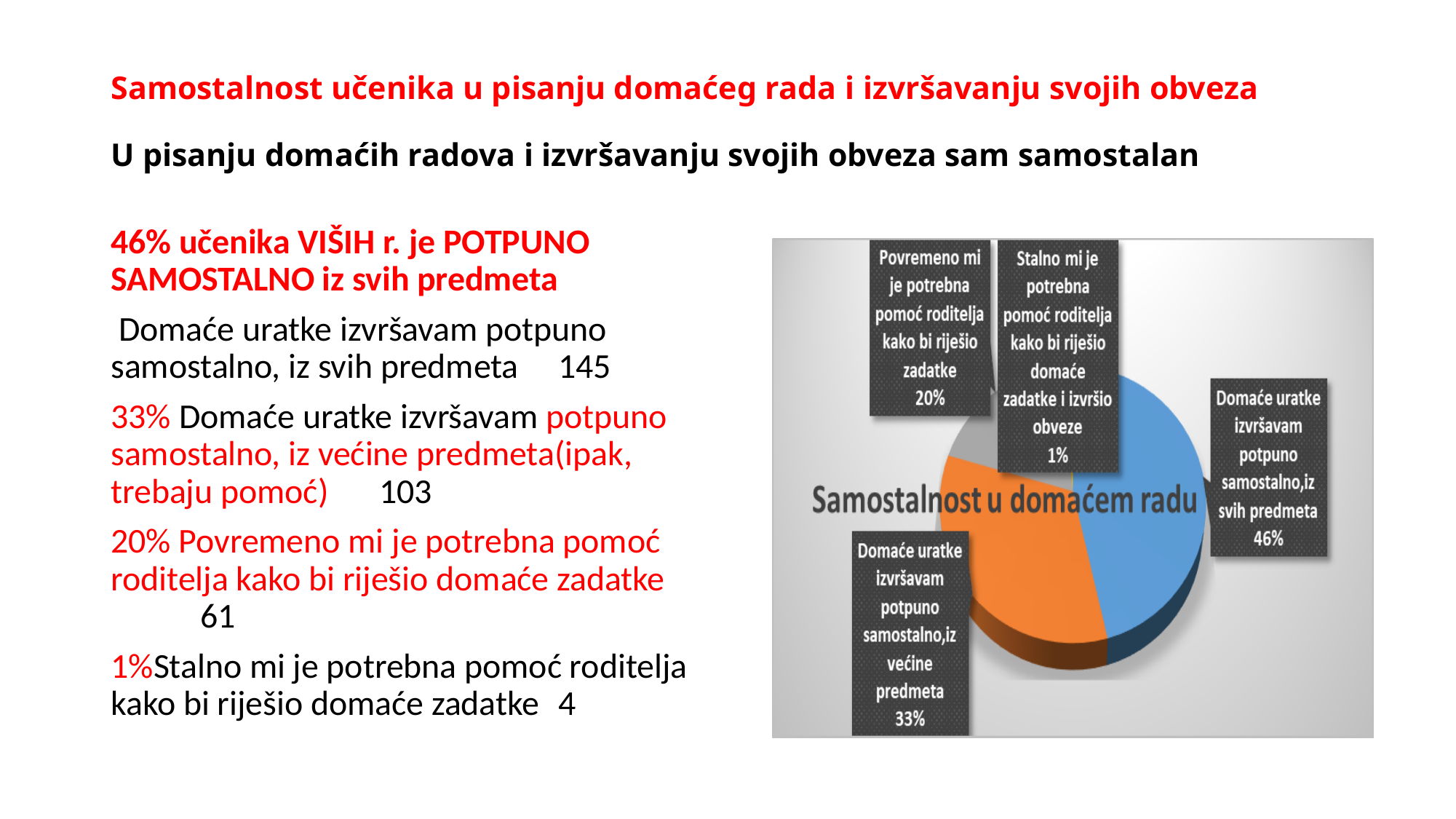
Which slice of the pie chart is the largest? Domaće uratke izvršavam potpuno samostalno, iz svih predmeta Which slice of the pie chart is the smallest? Stalno mi je potrebna pomoć roditelja kako bi riješio domaće zadatke i izvršio obveze What is the title of the chart? Samostalnost u domaćem radu Which is larger: the "Povremeno mi je potrebna pomoć roditelja" slice or the "iz većine predmeta" slice? iz većine predmeta What kind of chart is shown on the slide? pie chart What share of the pie is labelled "Domaće uratke izvršavam potpuno samostalno, iz većine predmeta"? 33% What colour is the largest slice of the pie chart? blue What share of the pie is labelled "Domaće uratke izvršavam potpuno samostalno, iz svih predmeta"? 46% How many slices does the pie chart have? 4 What share of the pie is labelled "Stalno mi je potrebna pomoć roditelja kako bi riješio domaće zadatke i izvršio obveze"? 1% What is the difference in percentage points between the "iz svih predmeta" slice and the "iz većine predmeta" slice? 13